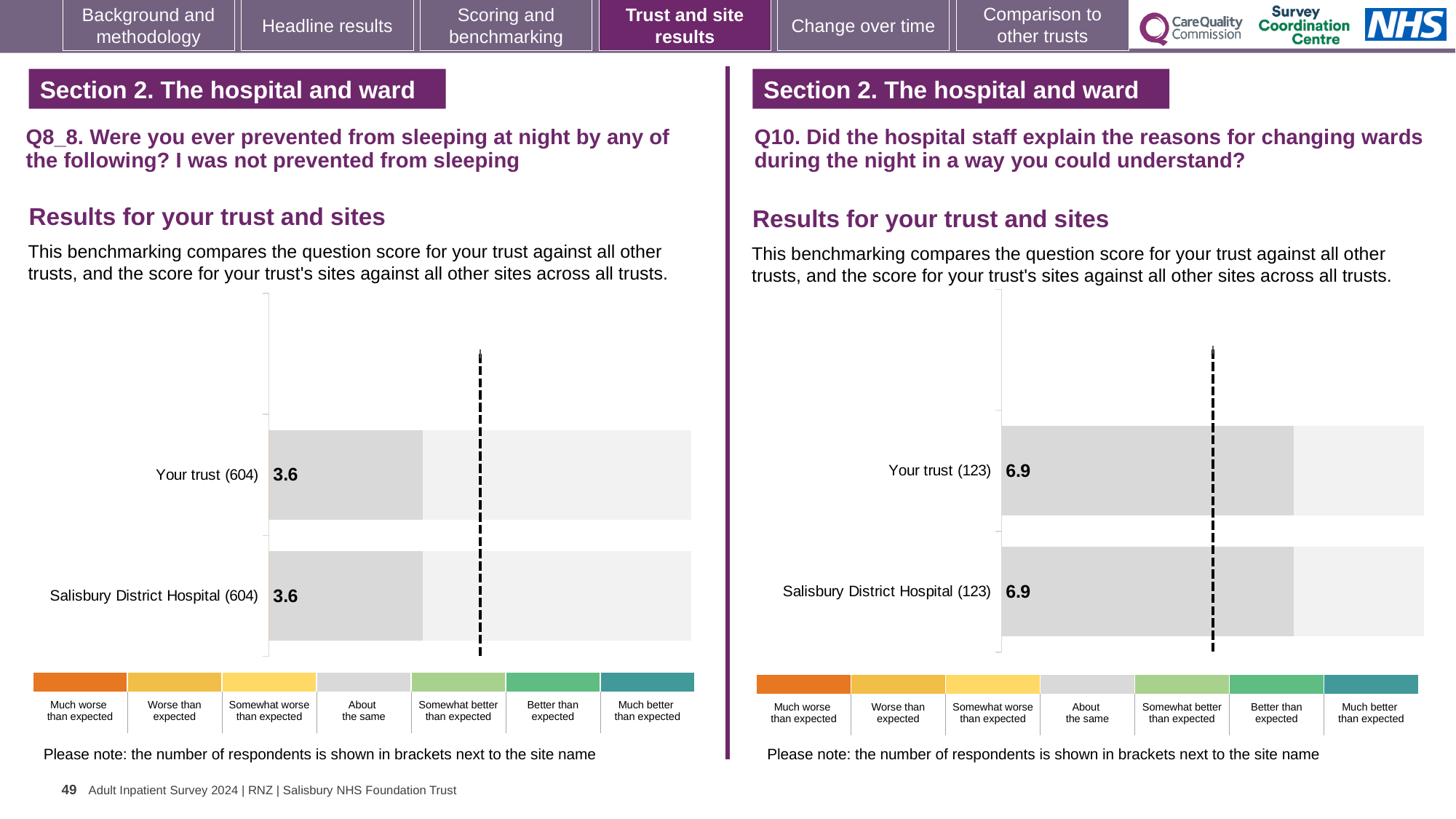
How many bars are plotted in the Q10 chart on the right? 2 Is the score for Your trust in the Q10 chart on the right larger or smaller than the score for Your trust in the Q8_8 chart on the left? Larger In the Q10 chart on the right, what is the difference between the score for Your trust and the score for Salisbury District Hospital? 0 In the Q8_8 chart on the left, how many respondents are shown in brackets for Your trust? 604 In the Q8_8 chart on the left, what is the difference between the score for Your trust and the score for Salisbury District Hospital? 0 What kind of chart is the Q10 chart on the right? Bar chart In the Q8_8 chart on the left, what is the score for Salisbury District Hospital? 3.6 In the Q10 chart on the right, what is the score for Salisbury District Hospital? 6.9 In the Q10 chart on the right, how many respondents are shown in brackets for Salisbury District Hospital? 123 In the Q8_8 chart on the left, what is the score for Your trust? 3.6 In the Q10 chart on the right, what is the score for Your trust? 6.9 How many bars are plotted in the Q8_8 chart on the left? 2